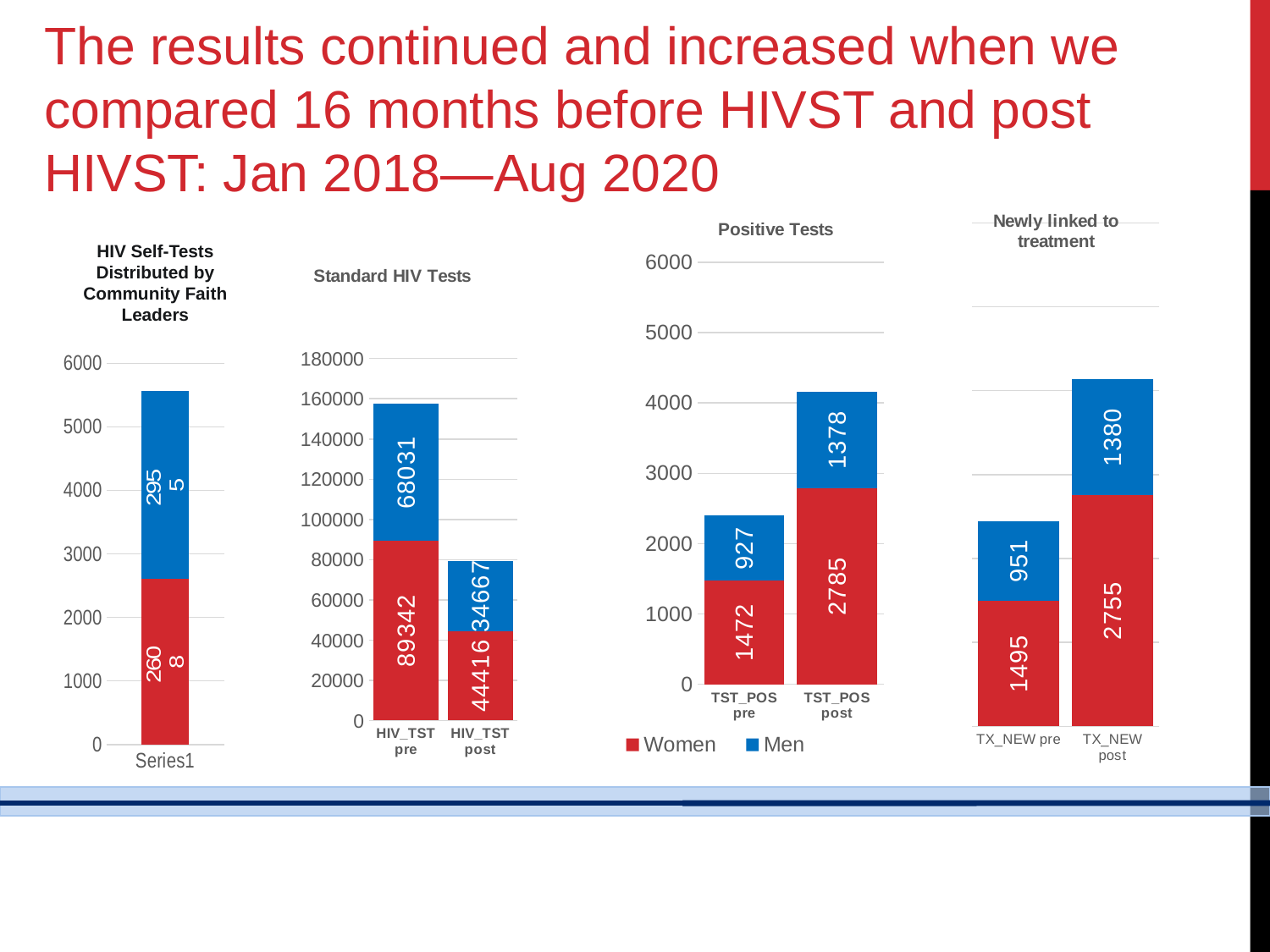
In the Newly linked to treatment chart, what is the total of the stacked bar for TX_NEW pre? 2446 In the Newly linked to treatment chart, is the total for TX_NEW post greater or less than 4000? greater In the Standard HIV Tests chart, what is the value of the red segment for HIV_TST pre? 89342 What kind of chart is the Newly linked to treatment chart? Stacked bar chart In the Positive Tests chart, what is the value for Women in TST_POS post? 2785 In the Positive Tests chart, which is larger: Women in TST_POS pre or Men in TST_POS post? Women in TST_POS pre In the Positive Tests chart, what is the value for Men in TST_POS pre? 927 In the Standard HIV Tests chart, what is the difference between the red segments for HIV_TST pre and HIV_TST post? 44926 In the Positive Tests chart, what is the total of the stacked bar for TST_POS post? 4163 In the Standard HIV Tests chart, which category has the taller stacked bar? HIV_TST pre In the Newly linked to treatment chart, what is the value of the blue segment for TX_NEW post? 1380 How many series does the legend of the Positive Tests chart list? 2